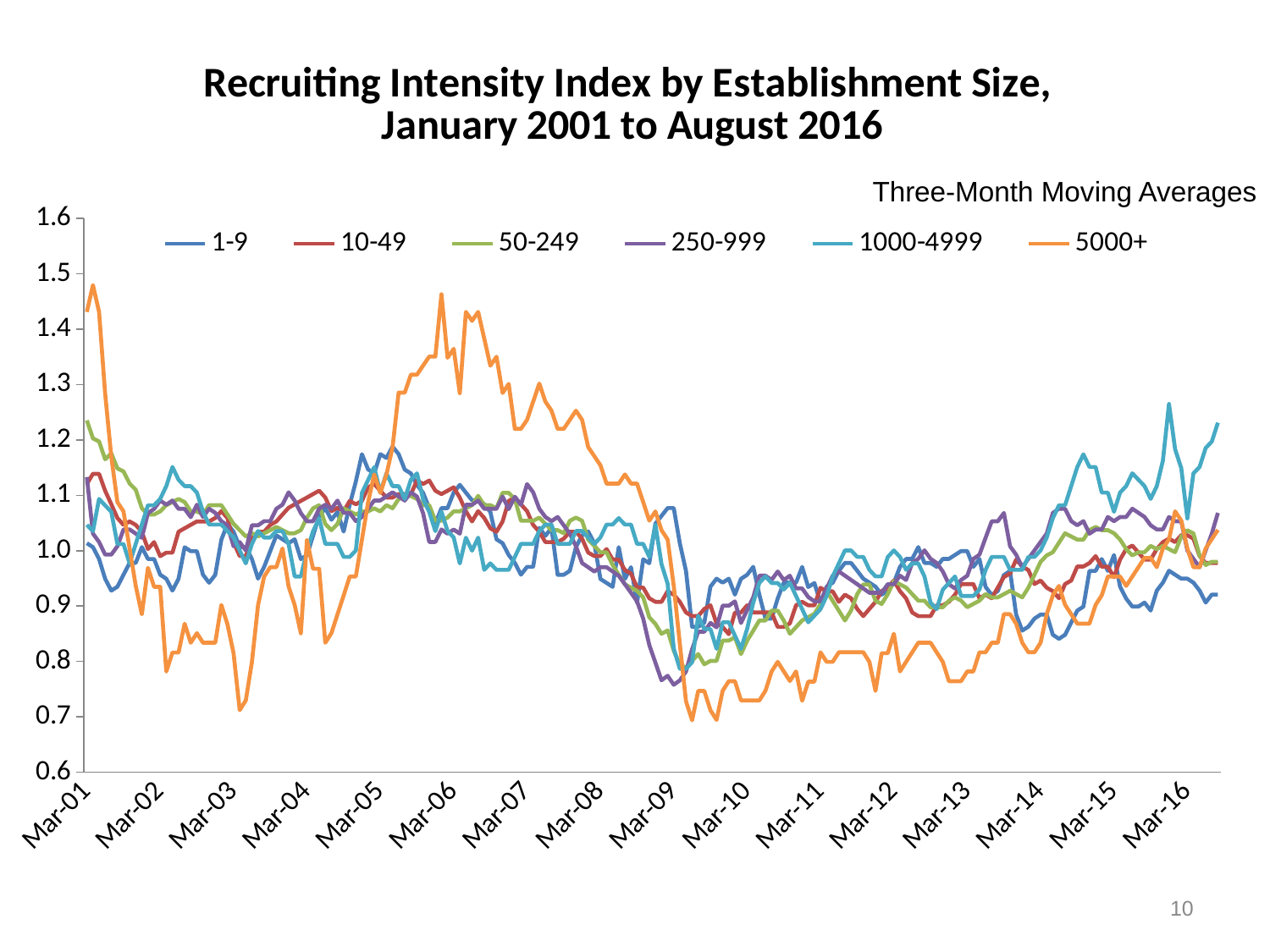
What is the title of the chart? Recruiting Intensity Index by Establishment Size, January 2001 to August 2016 At Mar-12, which is larger: the value for 10-49 or the value for 5000+? 10-49 How many series does the legend list? 6 What kind of chart is shown on the slide? line chart Which establishment size category is listed last in the legend? 5000+ Does the 5000+ series rise or fall between Mar-06 and Mar-09? fall Is the value for the 5000+ series at Mar-06 greater or less than 1.3? greater Is the value for the 5000+ series at Mar-10 greater or less than 0.8? less Is the value for the 250-999 series at Mar-09 greater or less than 0.9? less Which series reaches the highest value anywhere on the chart? 5000+ Which series has the lowest value around Mar-10? 5000+